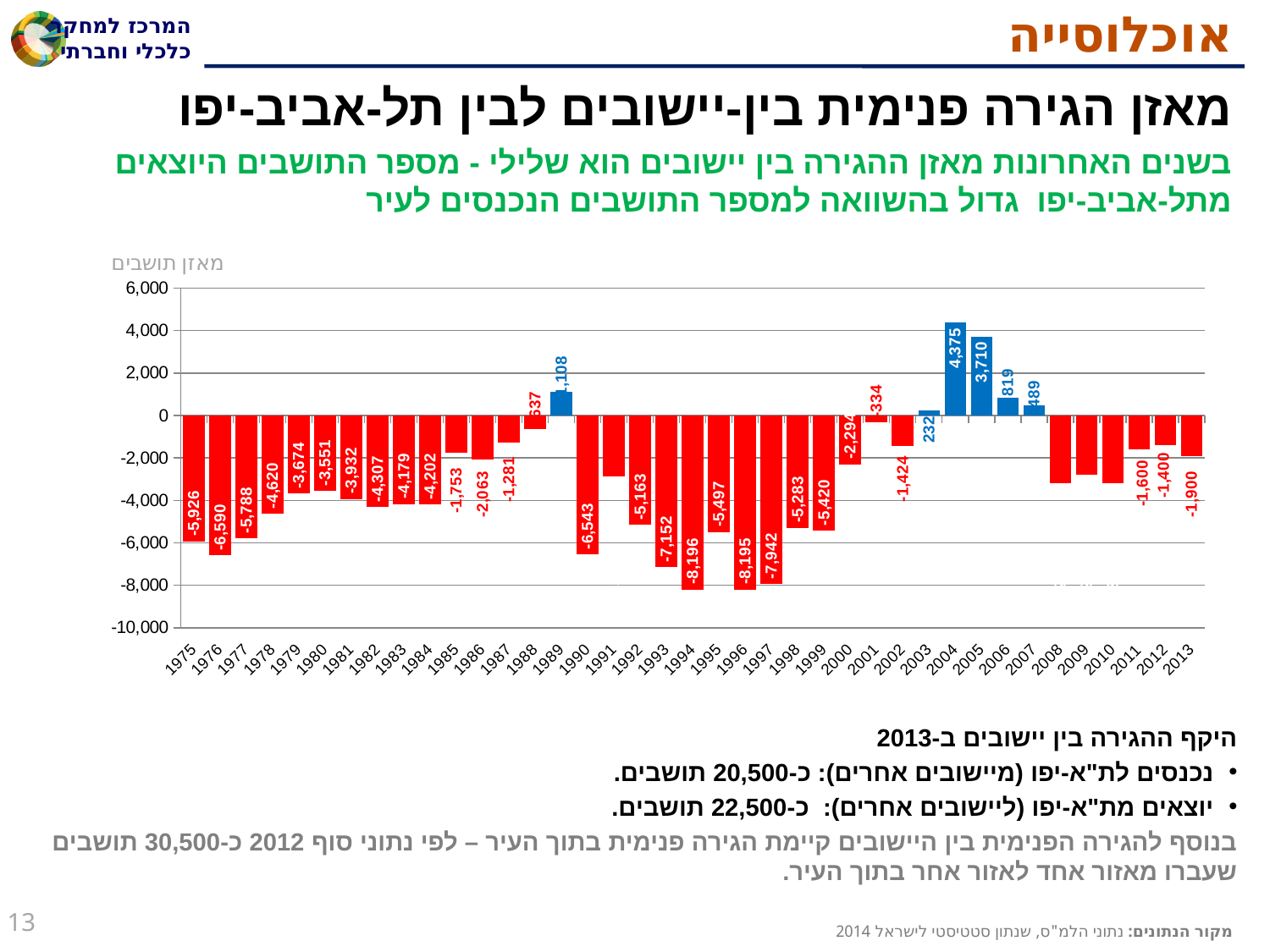
What is the difference between the values for 2004 and 2005? 665 Which year has the highest migration balance in the chart? 2004 Which year has the larger negative migration balance, 1990 or 1994? 1994 What is the migration balance value shown for 2001? -334 How many years are plotted on the x axis of the chart? 39 What kind of chart is shown on the slide? bar chart What is the migration balance value shown for 1976? -6,590 Do the values rise or fall from 2004 to 2007? fall What is the migration balance value shown for 2013? -1,900 What is the migration balance value shown for 2004? 4,375 Is the value for 1991 greater or less than -2,000? less Is the value for 2009 greater or less than -4,000? greater